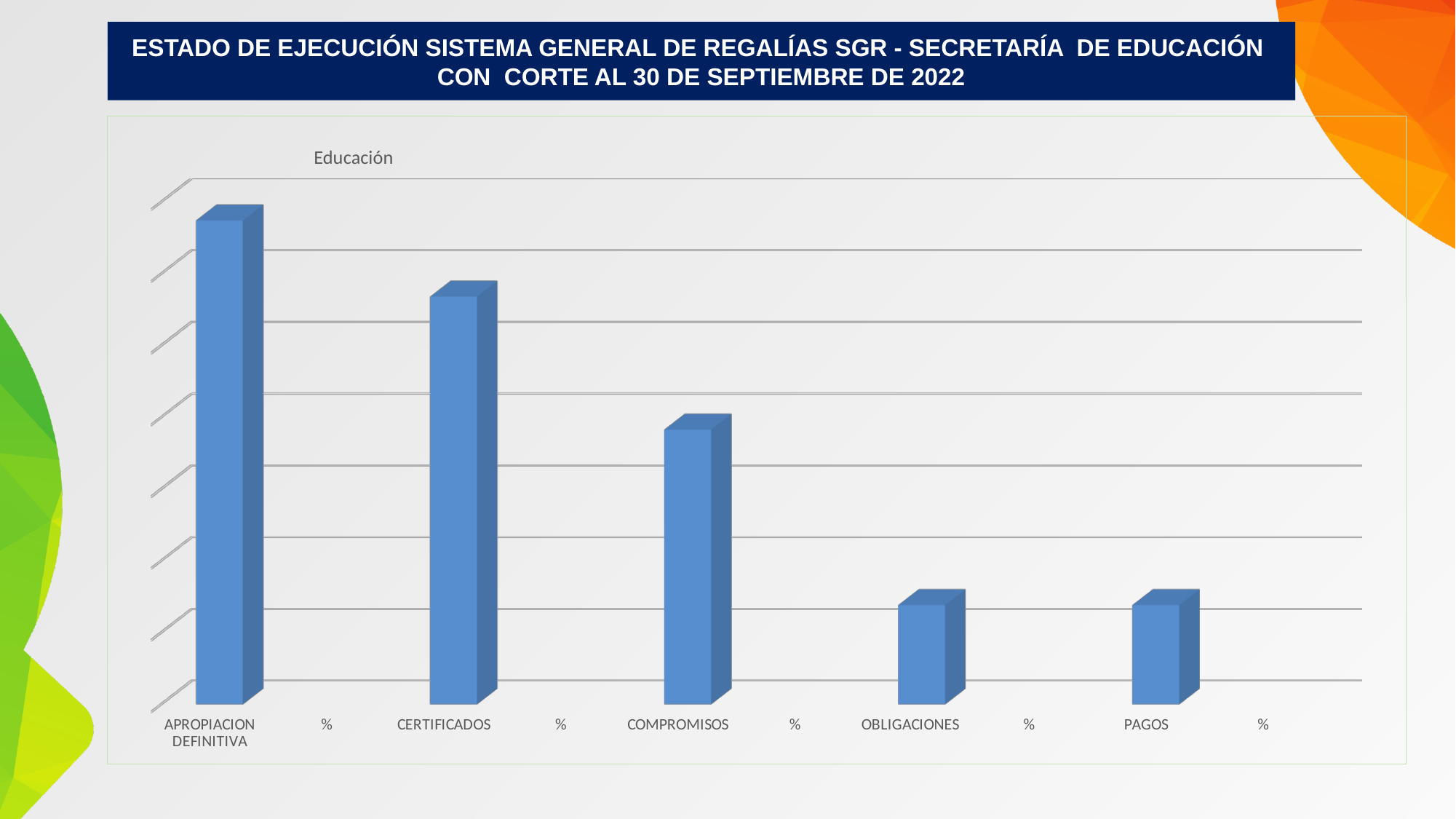
Do the bar heights rise or fall from APROPIACION DEFINITIVA to PAGOS along the x axis? fall Which category has the tallest bar in the chart? APROPIACION DEFINITIVA How many category labels are shown along the x axis of the chart? 10 What kind of chart is shown on the slide? bar chart What colour are the bars in the chart? blue Which bar is taller, COMPROMISOS or PAGOS? COMPROMISOS Which bar is taller, CERTIFICADOS or COMPROMISOS? CERTIFICADOS Which bar is taller, APROPIACION DEFINITIVA or CERTIFICADOS? APROPIACION DEFINITIVA How many categories on the x axis have a visible bar? 5 What is the title of the chart? Educación